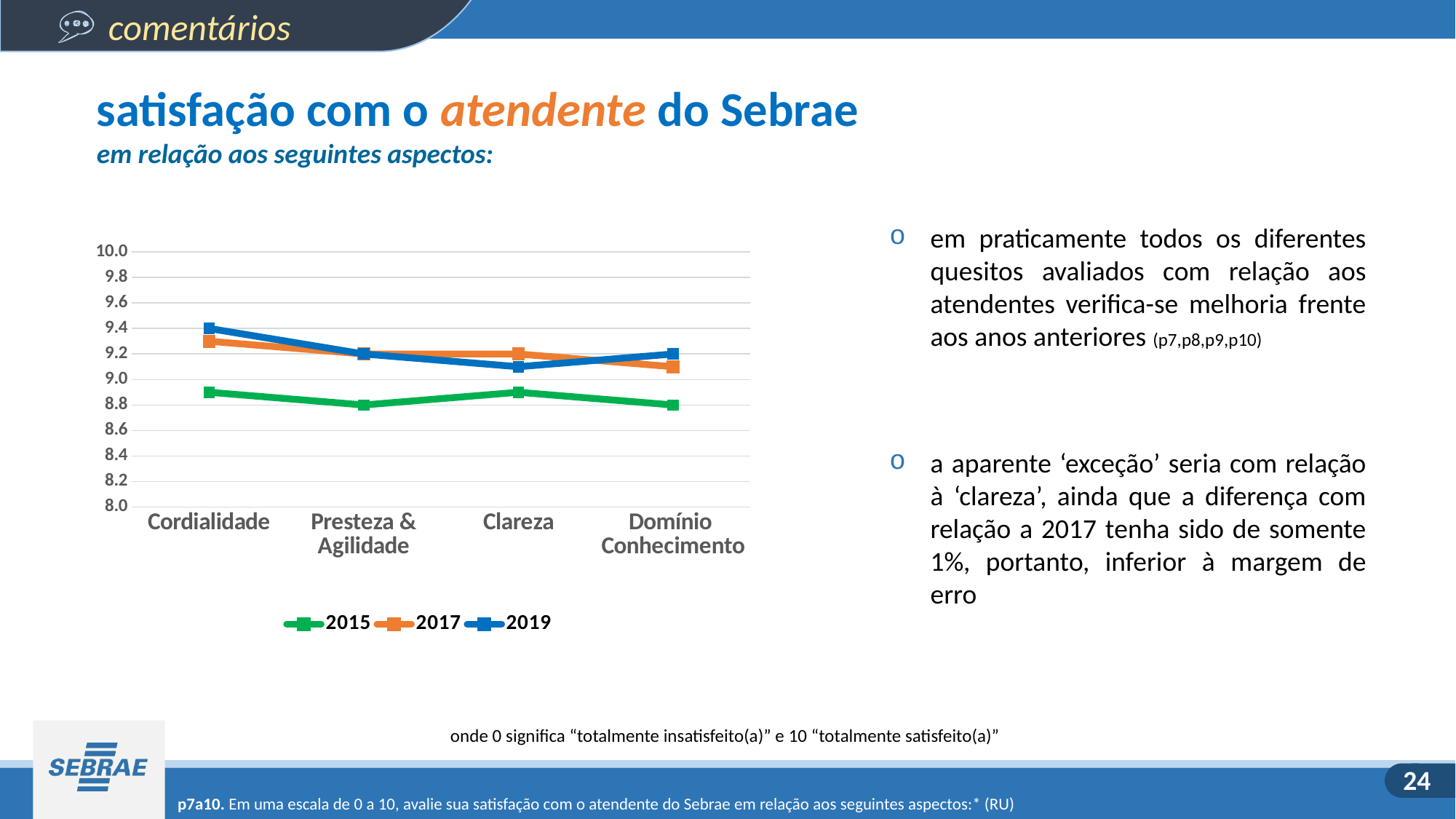
Is the 2015 value for Cordialidade greater or less than 9.0? less Does the 2019 series rise or fall from Cordialidade to Presteza & Agilidade? fall For the 2019 series, which category has the highest value? Cordialidade Is the 2017 value for Domínio Conhecimento greater or less than 9.0? greater For Cordialidade, which series has the larger value, 2015 or 2019? 2019 Which series is drawn in green in the chart? 2015 What kind of chart is shown on the slide? line chart How many categories are shown on the x axis of the chart? 4 How many series does the chart legend list? 3 Which years are listed in the chart legend? 2015, 2017, 2019 Is the 2019 value for Cordialidade greater or less than 9.2? greater For the 2017 series, which category has the highest value? Cordialidade